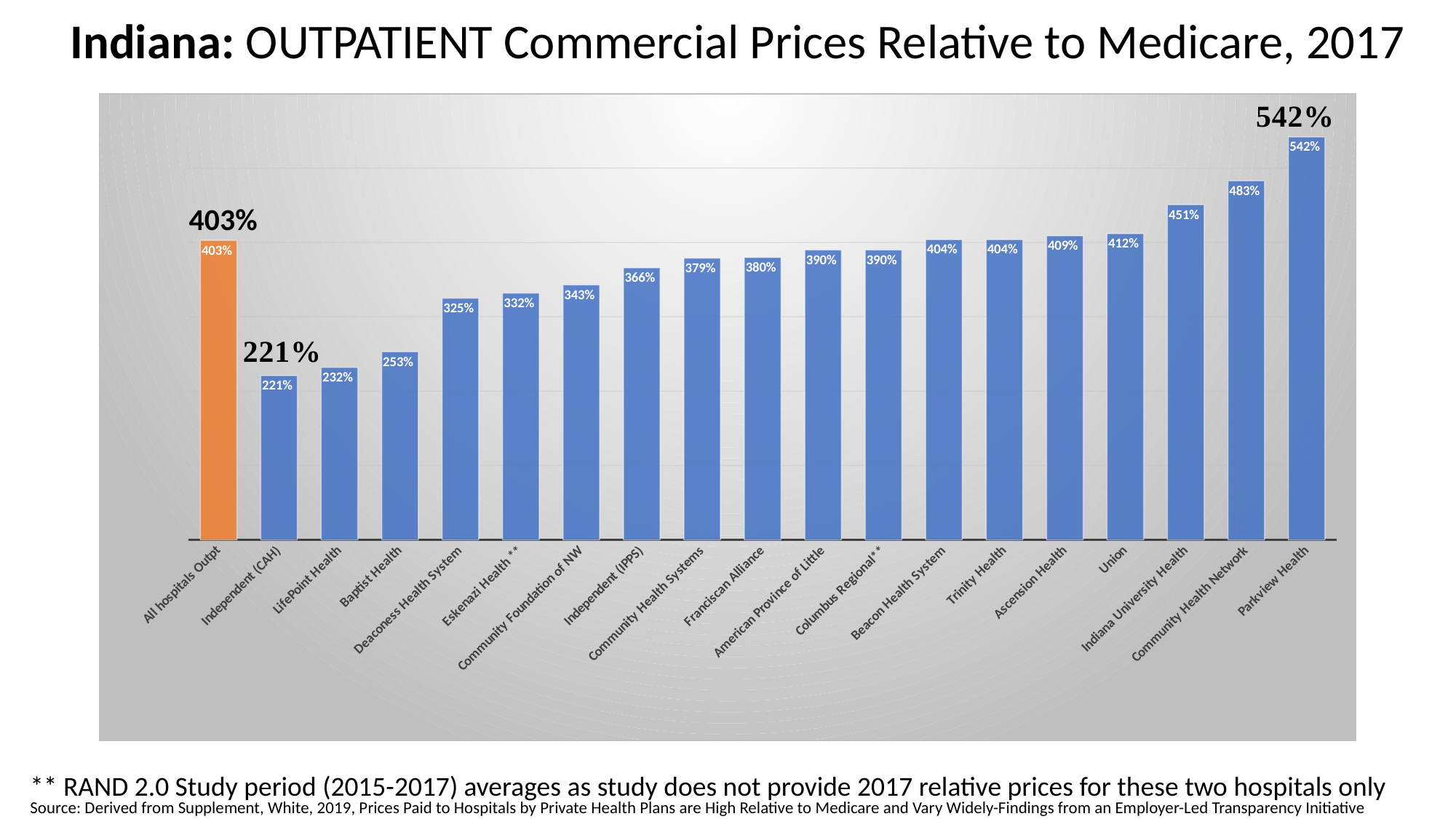
What is the value for Union? 412% What is the value for Parkview Health? 542% Which is larger, the value for Baptist Health or the value for LifePoint Health? Baptist Health Which bar is shown in orange rather than blue? All hospitals Outpt Which category has the highest value? Parkview Health What kind of chart is shown on the slide? Bar chart How many bars are shown in the chart? 19 What is the difference between the values for Community Health Network and Indiana University Health? 32% What is the value for All hospitals Outpt? 403% What is the difference between the values for Parkview Health and Independent (CAH)? 321% What is the value for Deaconess Health System? 325% Which category has the lowest value? Independent (CAH)